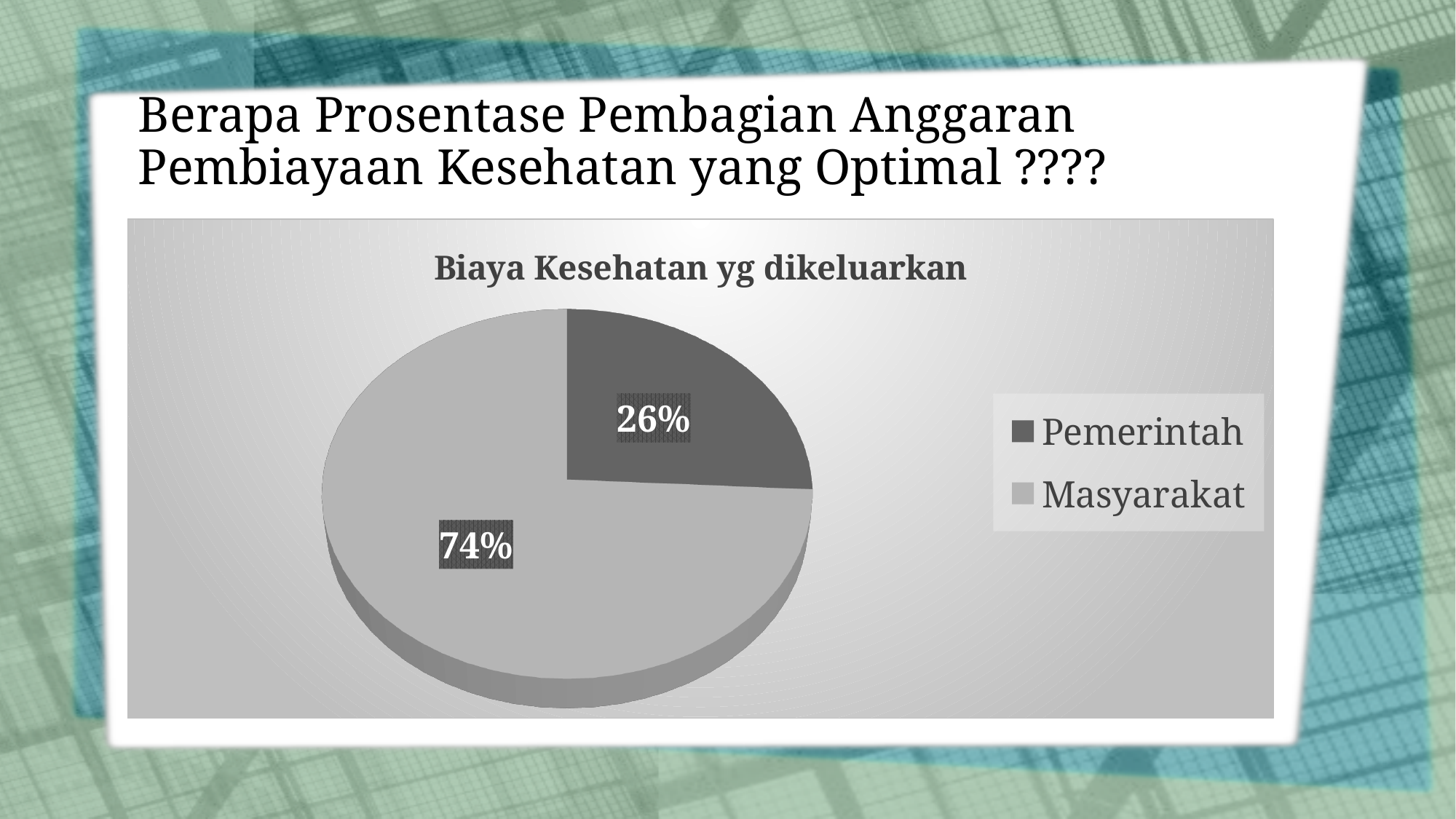
What is the difference in percentage points between Masyarakat and Pemerintah? 48% What is the title of the chart? Biaya Kesehatan yg dikeluarkan What percentage of the pie is Masyarakat? 74% What kind of chart is shown on the slide? Pie chart Which legend entry is shown in the darker grey colour? Pemerintah What percentage of the pie is Pemerintah? 26% How many entries does the legend list? 2 Which category has the largest share of the pie? Masyarakat Which category has the smallest share of the pie? Pemerintah How many categories does the pie chart show? 2 Which is larger, the share for Pemerintah or the share for Masyarakat? Masyarakat